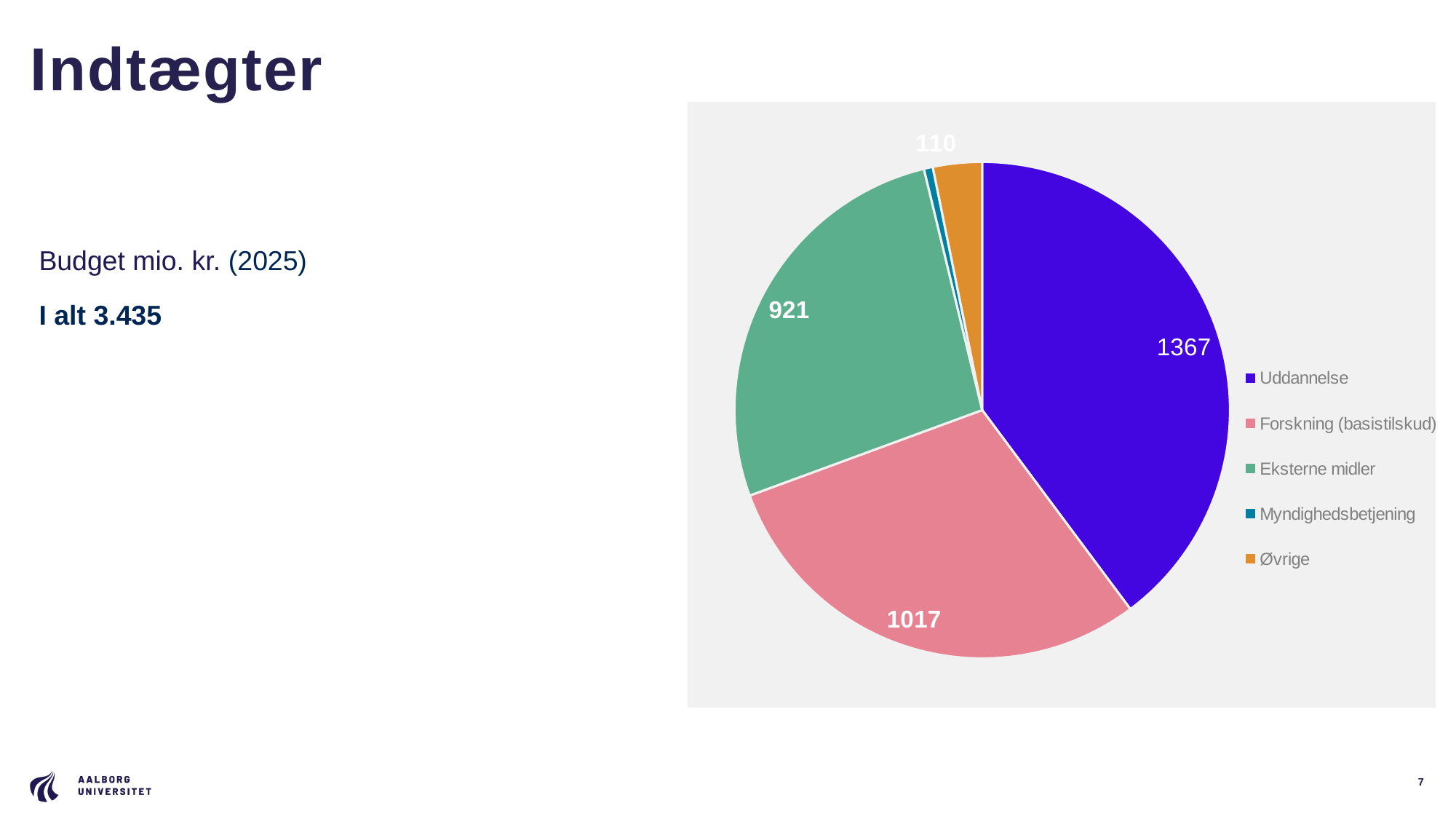
What is the value for Øvrige in the pie chart? 110 What is the difference between the values for Forskning (basistilskud) and Eksterne midler? 96 What is the difference between the values for Uddannelse and Forskning (basistilskud)? 350 What is the title of the slide containing the pie chart? Indtægter What is the value for Forskning (basistilskud) in the pie chart? 1017 How many categories does the pie chart show? 5 Which is larger, the value for Eksterne midler or the value for Øvrige? Eksterne midler Which category has the smallest slice in the pie chart? Myndighedsbetjening What is the value for Eksterne midler in the pie chart? 921 What kind of chart is shown on the slide? pie chart Which category has the largest slice in the pie chart? Uddannelse What is the value for Uddannelse in the pie chart? 1367